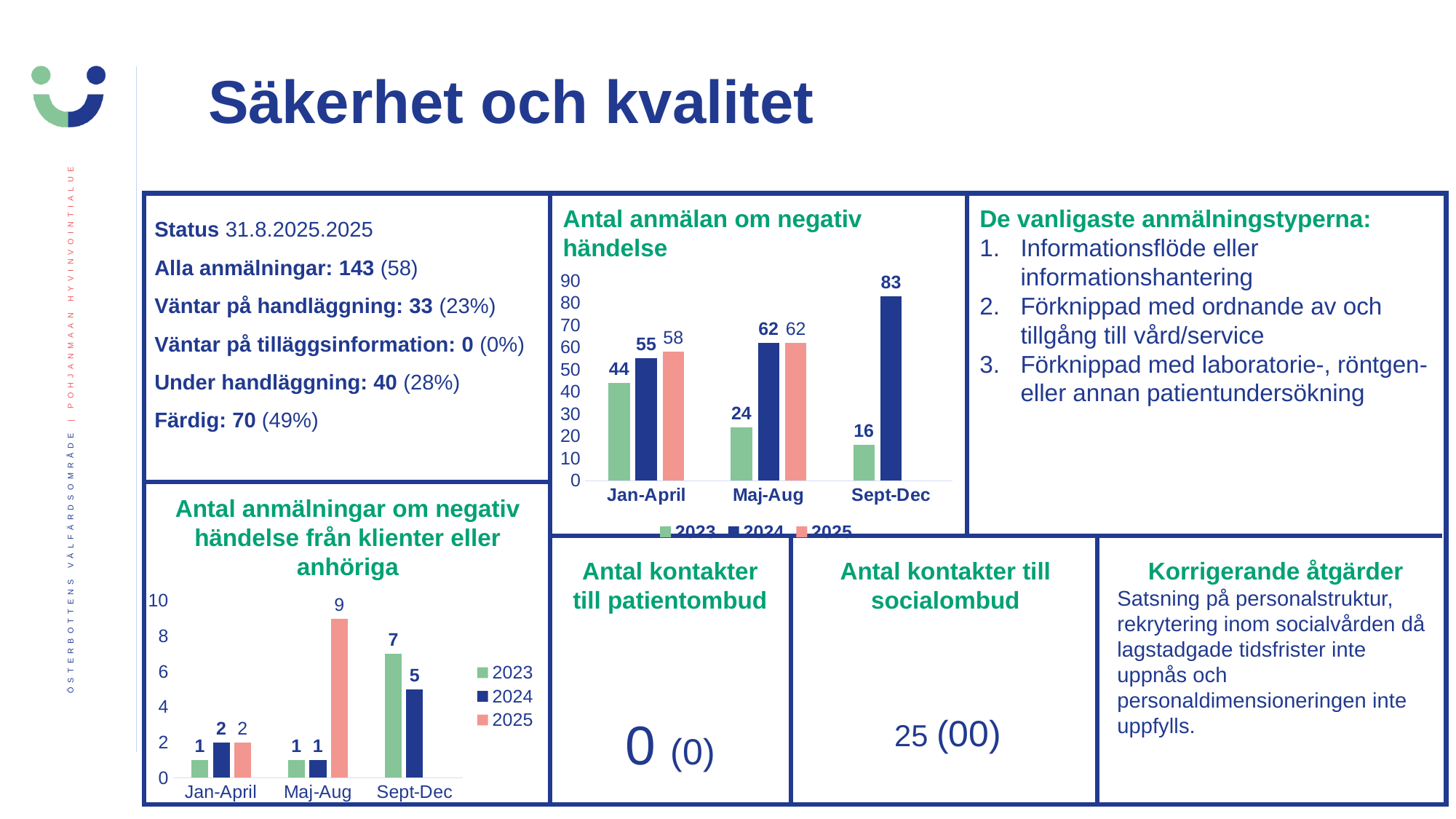
In the chart 'Antal anmälningar om negativ händelse från klienter eller anhöriga', which is larger in Sept-Dec: 2023 or 2024? 2023 In the chart 'Antal anmälan om negativ händelse', how many series does the legend list? 3 What kind of chart is 'Antal anmälningar om negativ händelse från klienter eller anhöriga'? bar chart In the chart 'Antal anmälningar om negativ händelse från klienter eller anhöriga', what is the value for 2023 in Sept-Dec? 7 In the chart 'Antal anmälningar om negativ händelse från klienter eller anhöriga', what is the value for 2025 in Maj-Aug? 9 In the chart 'Antal anmälan om negativ händelse', what is the difference between the 2024 and 2023 values in Jan-April? 11 In the chart 'Antal anmälan om negativ händelse', do the 2023 values rise or fall from Jan-April to Sept-Dec? fall In the chart 'Antal anmälan om negativ händelse', what is the value for 2024 in Sept-Dec? 83 In the chart 'Antal anmälan om negativ händelse', what is the value for 2023 in Maj-Aug? 24 In the chart 'Antal anmälan om negativ händelse', which period has the lowest value for 2023? Sept-Dec In the chart 'Antal anmälningar om negativ händelse från klienter eller anhöriga', how many periods are shown on the x axis? 3 In the chart 'Antal anmälan om negativ händelse', which period has the highest value for 2024? Sept-Dec